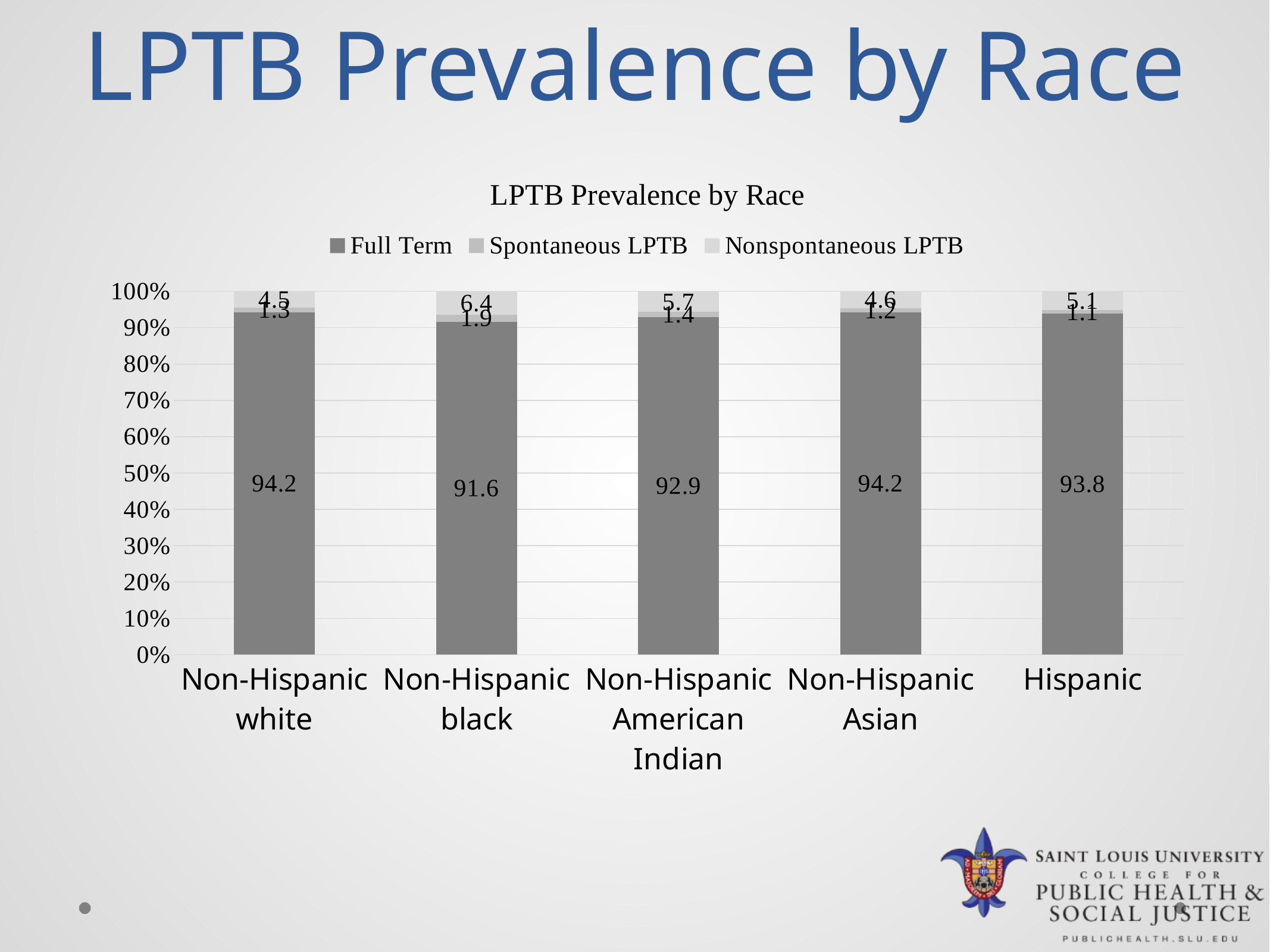
What is the difference between the Nonspontaneous LPTB values for Non-Hispanic black and Non-Hispanic white? 1.9 What is the Nonspontaneous LPTB value for Non-Hispanic American Indian? 5.7 How many race categories are shown on the x axis? 5 Which race category has the lowest Full Term value? Non-Hispanic black Which race category has the highest Nonspontaneous LPTB value? Non-Hispanic black Which race category has the highest Spontaneous LPTB value? Non-Hispanic black How many series does the legend list? 3 Which is larger, the Full Term value for Non-Hispanic American Indian or for Hispanic? Hispanic What is the Spontaneous LPTB value for Hispanic? 1.1 What kind of chart is shown on the slide? Stacked bar chart What is the Full Term value for Non-Hispanic black? 91.6 What is the Full Term value for Non-Hispanic Asian? 94.2